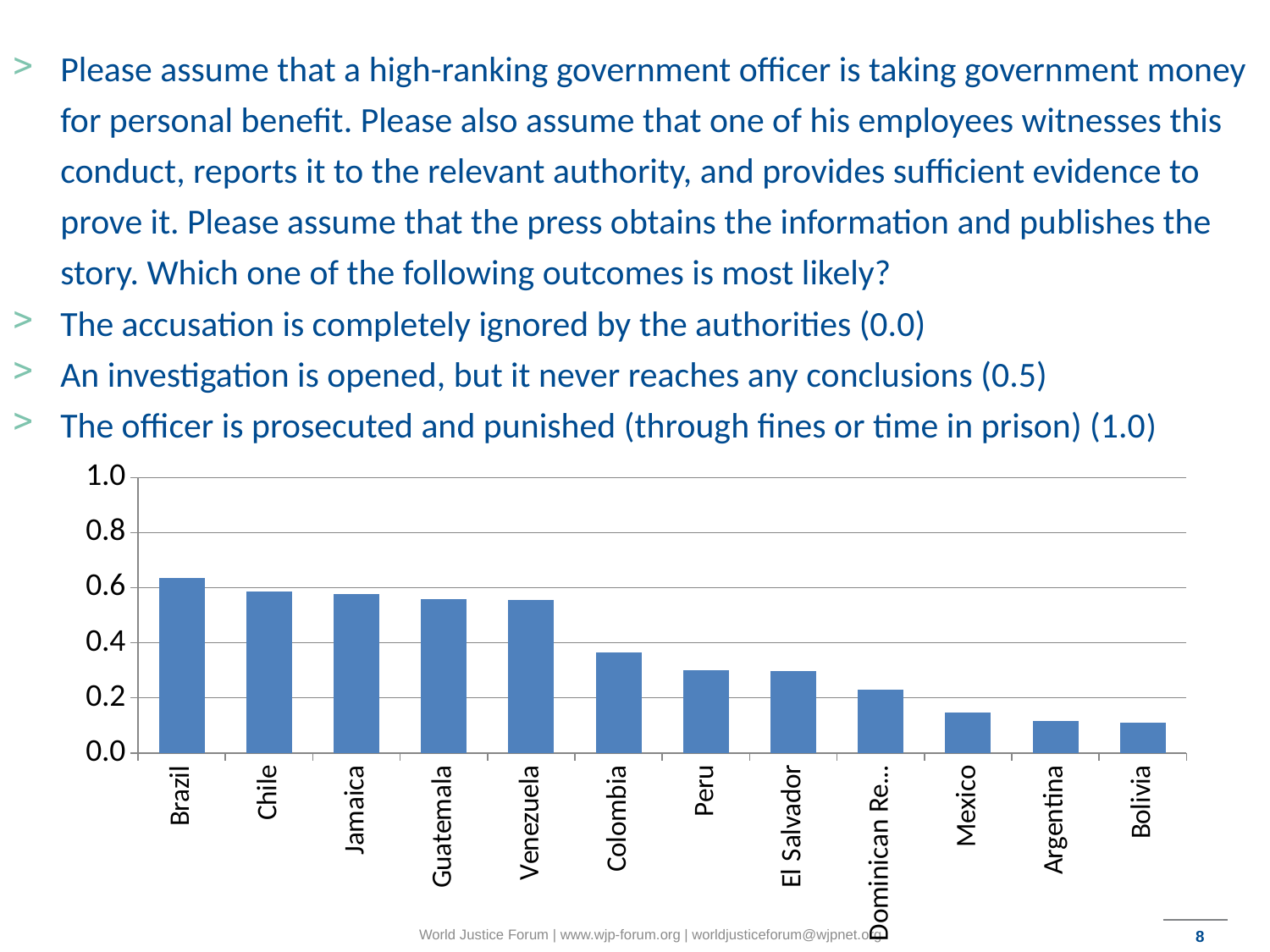
Which has the larger value, Peru or Mexico? Peru Is the value for Brazil greater or less than 0.4? greater Which has the larger value, Brazil or Colombia? Brazil How many countries are shown on the x axis of the chart? 12 Is the value for Bolivia greater or less than 0.2? less Which country has the highest value in the chart? Brazil What is the highest value shown on the y axis of the chart? 1.0 Do the values rise or fall moving from left to right along the x axis? fall What kind of chart is shown on the slide? bar chart Is the value for Mexico greater or less than 0.2? less